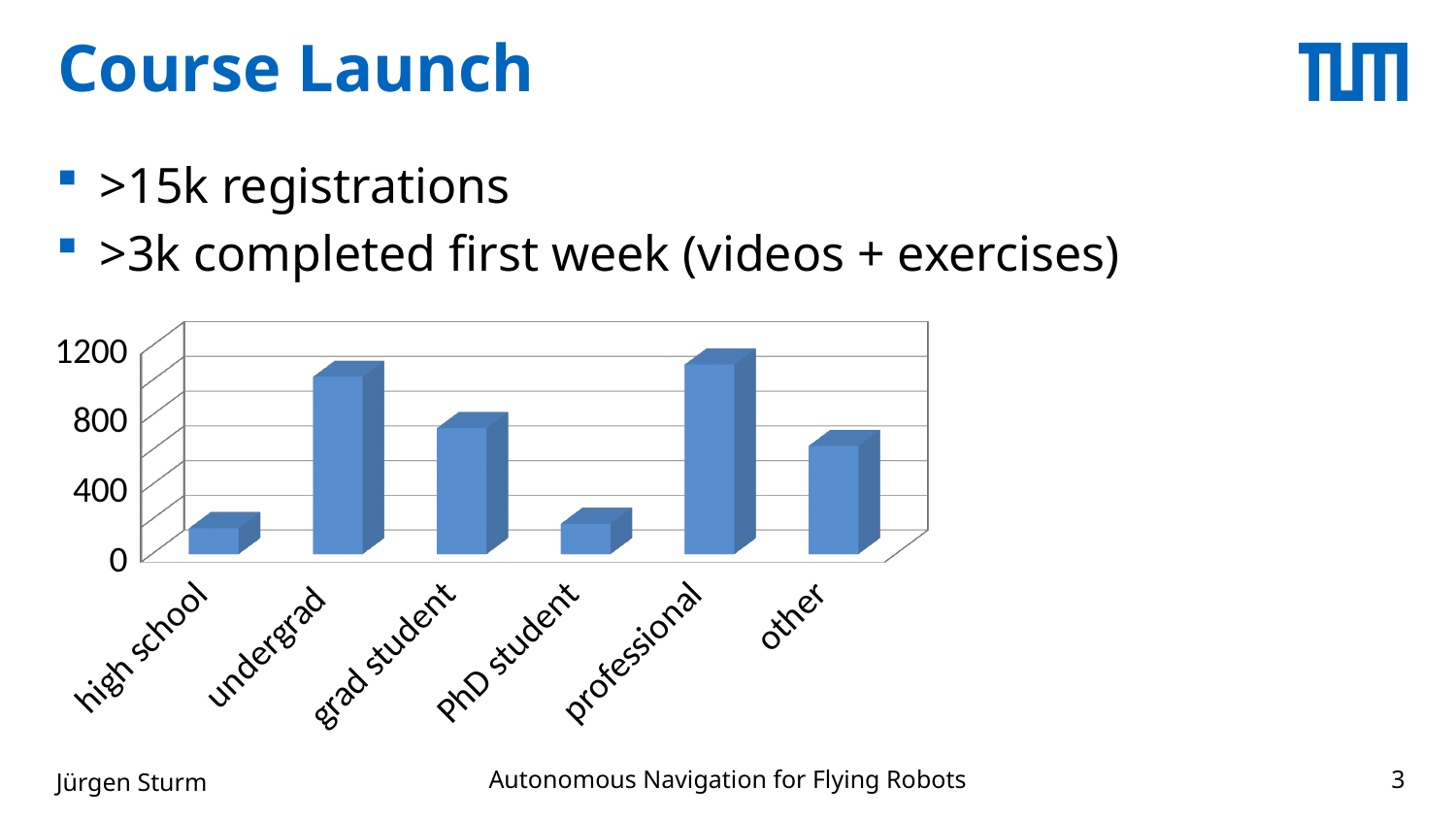
How many categories are shown on the x axis of the chart? 6 Is the value for high school greater or less than 400? less What kind of chart is shown on the slide? bar chart Is the value for undergrad greater or less than 800? greater Is the value for professional greater or less than 800? greater Which is larger, the value for undergrad or the value for grad student? undergrad Which is larger, the value for professional or the value for other? professional Which category has the highest bar in the chart? professional Which is larger, the value for grad student or the value for PhD student? grad student